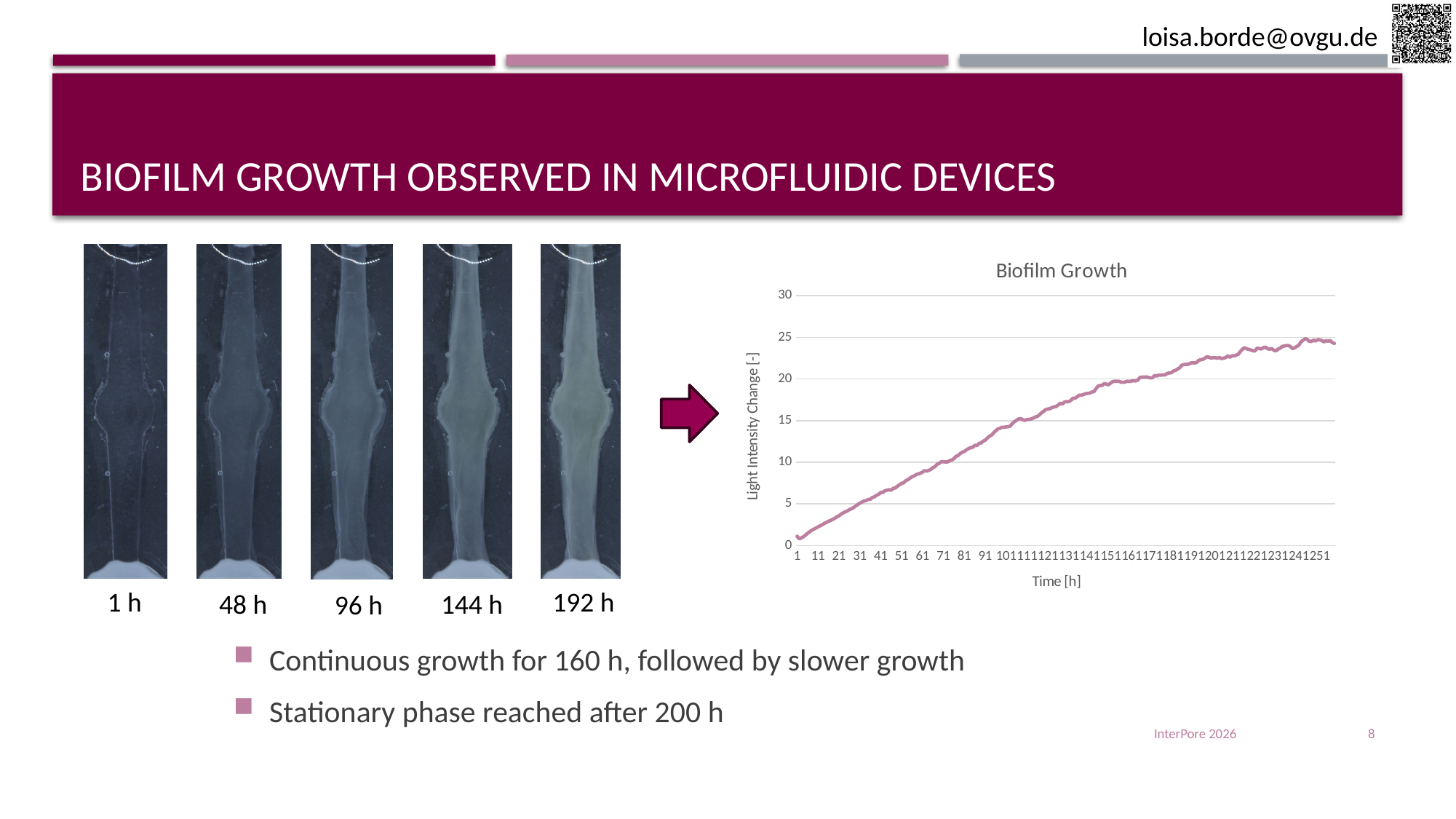
In the "Biofilm Growth" chart, is the value at 51 h greater or less than 10? less What is the label of the y axis of the "Biofilm Growth" chart? Light Intensity Change [-] How many data series are plotted in the "Biofilm Growth" chart? 1 In the "Biofilm Growth" chart, is the value at 121 h greater or less than 15? greater In the "Biofilm Growth" chart, does the light intensity change rise or fall as time increases? rise In the "Biofilm Growth" chart, which is larger, the value at 51 h or the value at 151 h? 151 h In the "Biofilm Growth" chart, is the value at 41 h greater or less than 5? greater What kind of chart is the "Biofilm Growth" chart? line chart What is the title of the chart on the slide? Biofilm Growth